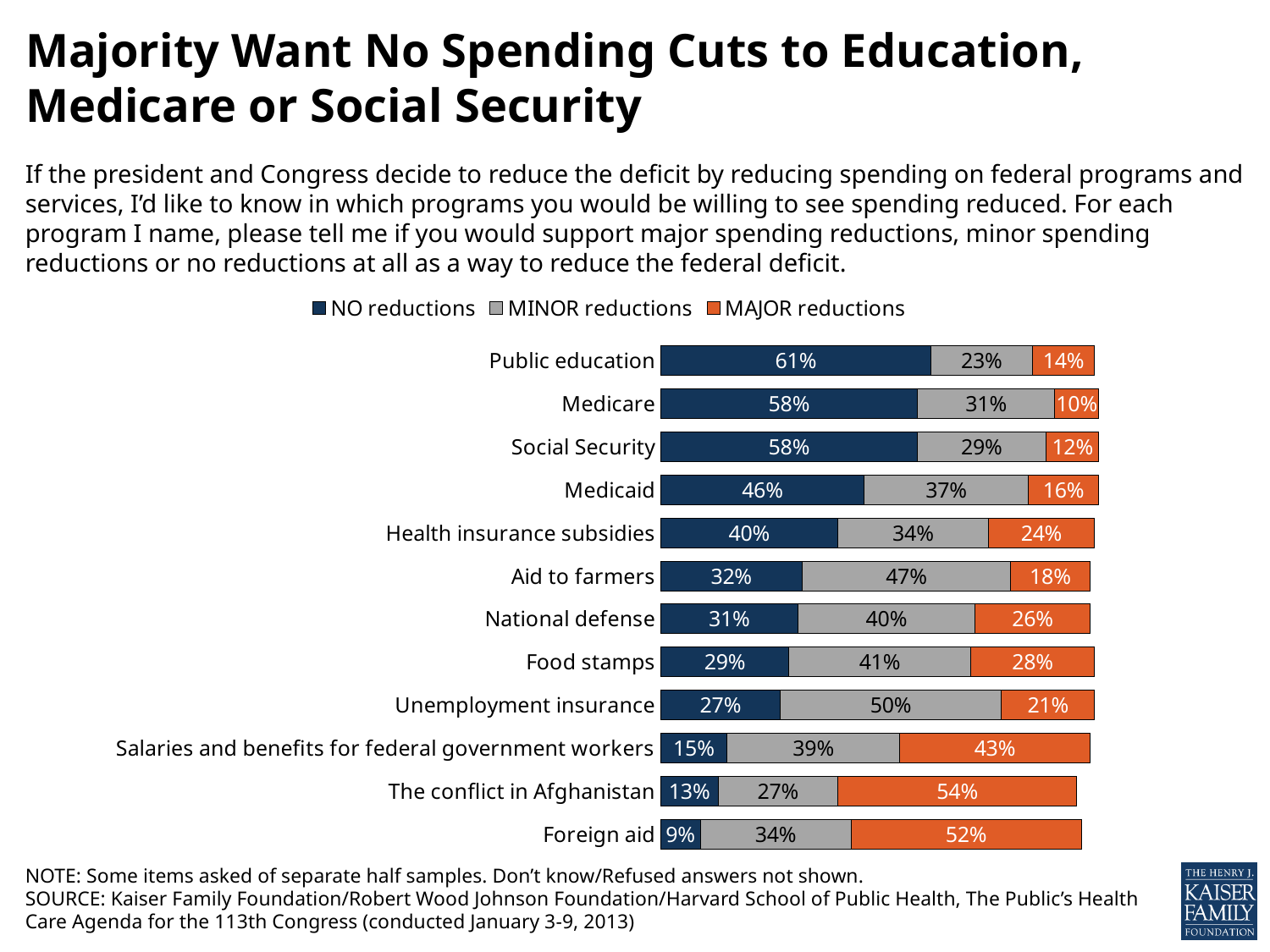
How many percentage points higher is the NO reductions value for Public education than for Medicaid? 15 percentage points Which program has the lowest share of respondents wanting NO reductions? Foreign aid Which program has the highest share of respondents wanting NO reductions? Public education Which program has the highest share supporting MAJOR reductions? The conflict in Afghanistan What percentage support MAJOR reductions for Foreign aid? 52% How many programs are listed in the chart? 12 Which has a larger MAJOR reductions value: Health insurance subsidies or Aid to farmers? Health insurance subsidies How many series does the legend list? 3 What kind of chart is shown on the slide? Stacked bar chart What is the MINOR reductions value for Unemployment insurance? 50% What percentage of respondents want NO reductions for Medicare? 58% What is the total of the three segments for the Public education bar? 98%